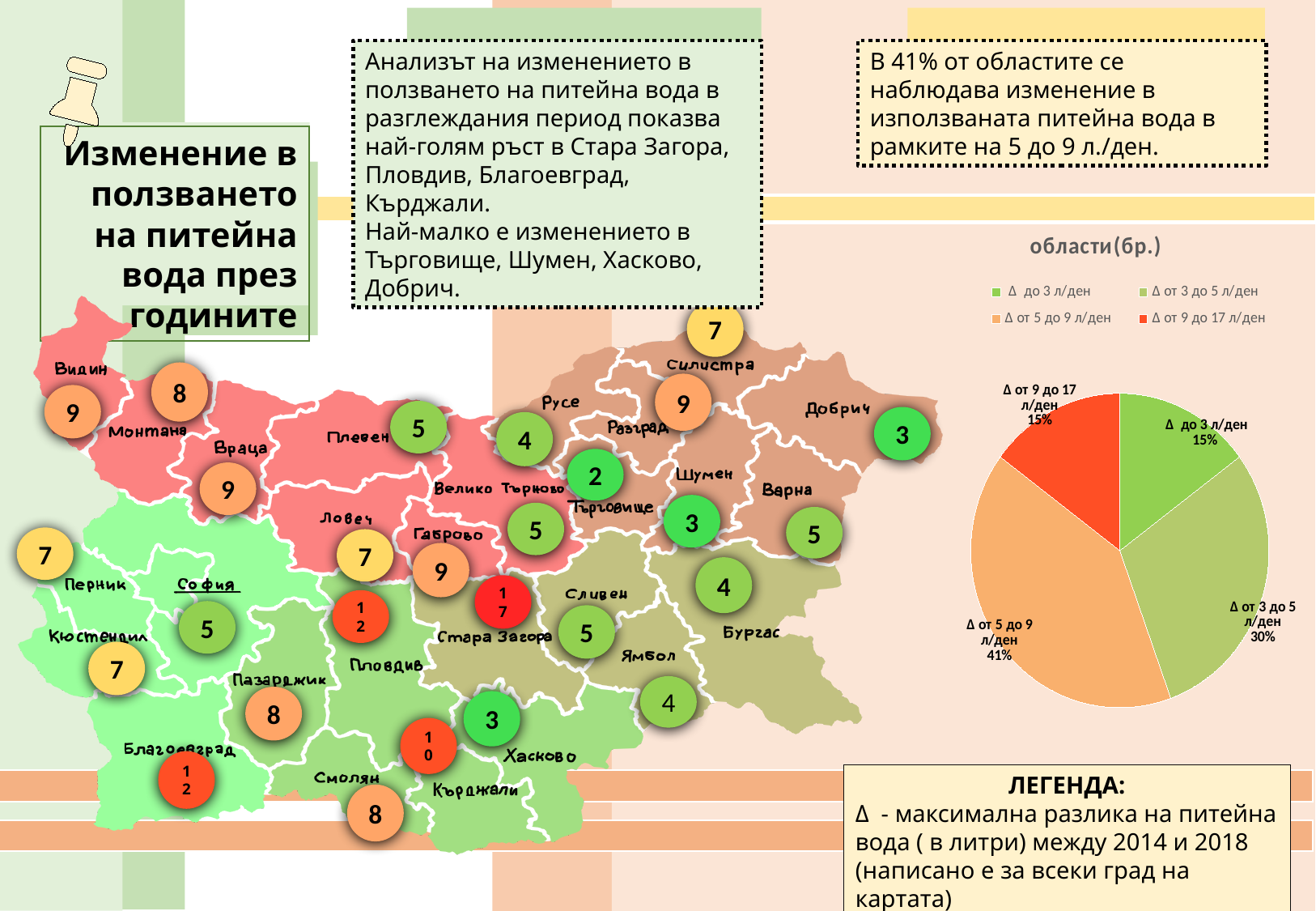
In the pie chart, which slice is larger: Δ от 3 до 5 л/ден or Δ от 9 до 17 л/ден? Δ от 3 до 5 л/ден In the pie chart, what share is labelled for the slice Δ до 3 л/ден? 15% What is the title of the pie chart? области(бр.) In the pie chart, what share is labelled for the slice Δ от 5 до 9 л/ден? 41% Which slice of the pie chart is the largest? Δ от 5 до 9 л/ден In the pie chart, what share is labelled for the slice Δ от 3 до 5 л/ден? 30% How many slices does the pie chart have? 4 What kind of chart is shown on the right side of the slide? pie chart Which slice of the pie chart is coloured red? Δ от 9 до 17 л/ден In the pie chart, by how many percentage points does the Δ от 5 до 9 л/ден slice exceed the Δ от 3 до 5 л/ден slice? 11 percentage points How many entries does the legend of the pie chart list? 4